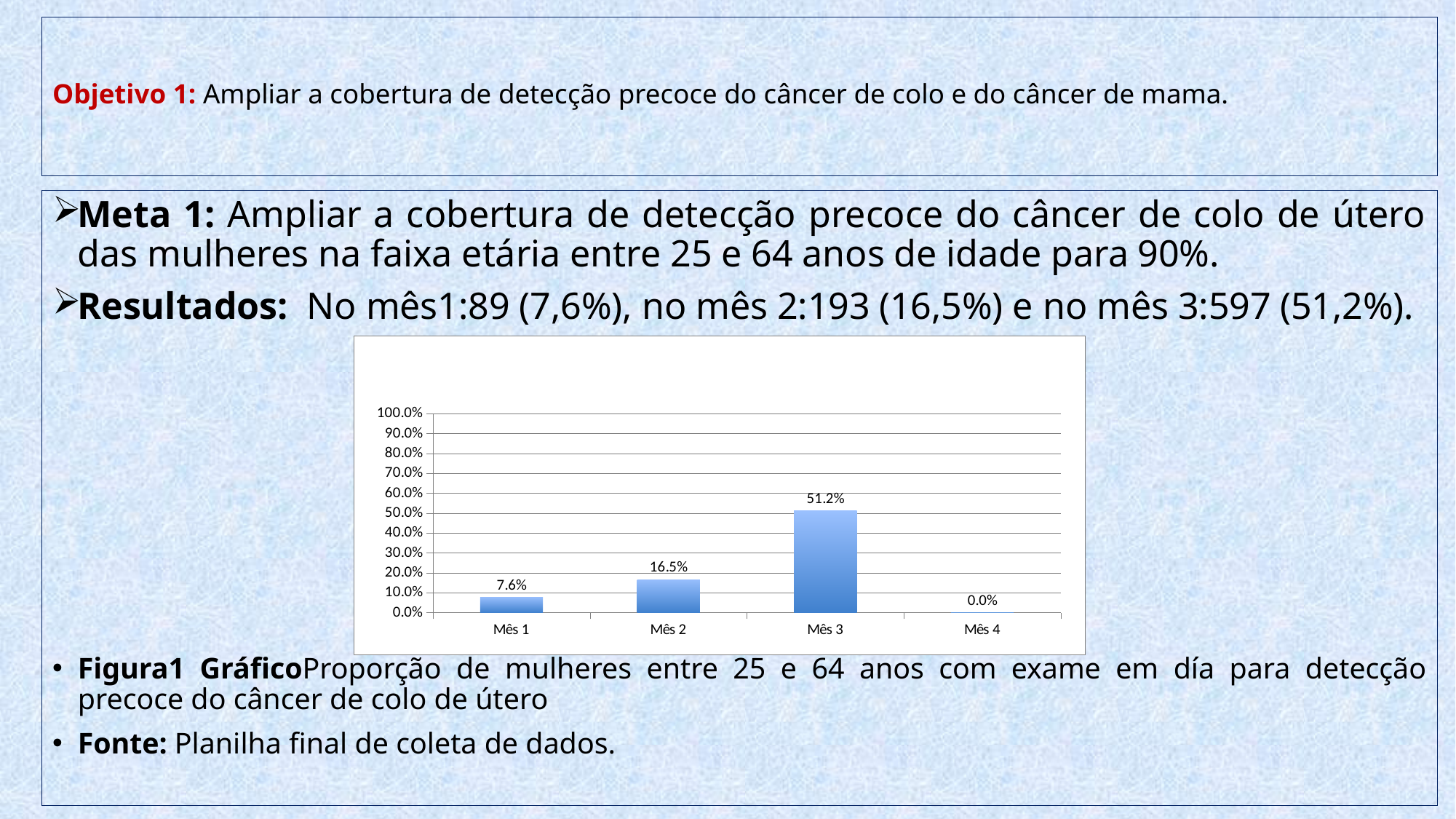
What is the value for Mês 2? 16.5% What kind of chart is shown? bar chart Which category has the highest value? Mês 3 What is the value for Mês 3? 51.2% What is the value for Mês 1? 7.6% What is the difference between the values for Mês 3 and Mês 2? 34.7% Do the values rise or fall from Mês 1 to Mês 3? rise Which category has the lowest value? Mês 4 How many categories are shown on the x axis? 4 Is the value for Mês 3 greater or less than 50.0%? greater What is the value for Mês 4? 0.0% Which is larger, the value for Mês 1 or the value for Mês 2? Mês 2